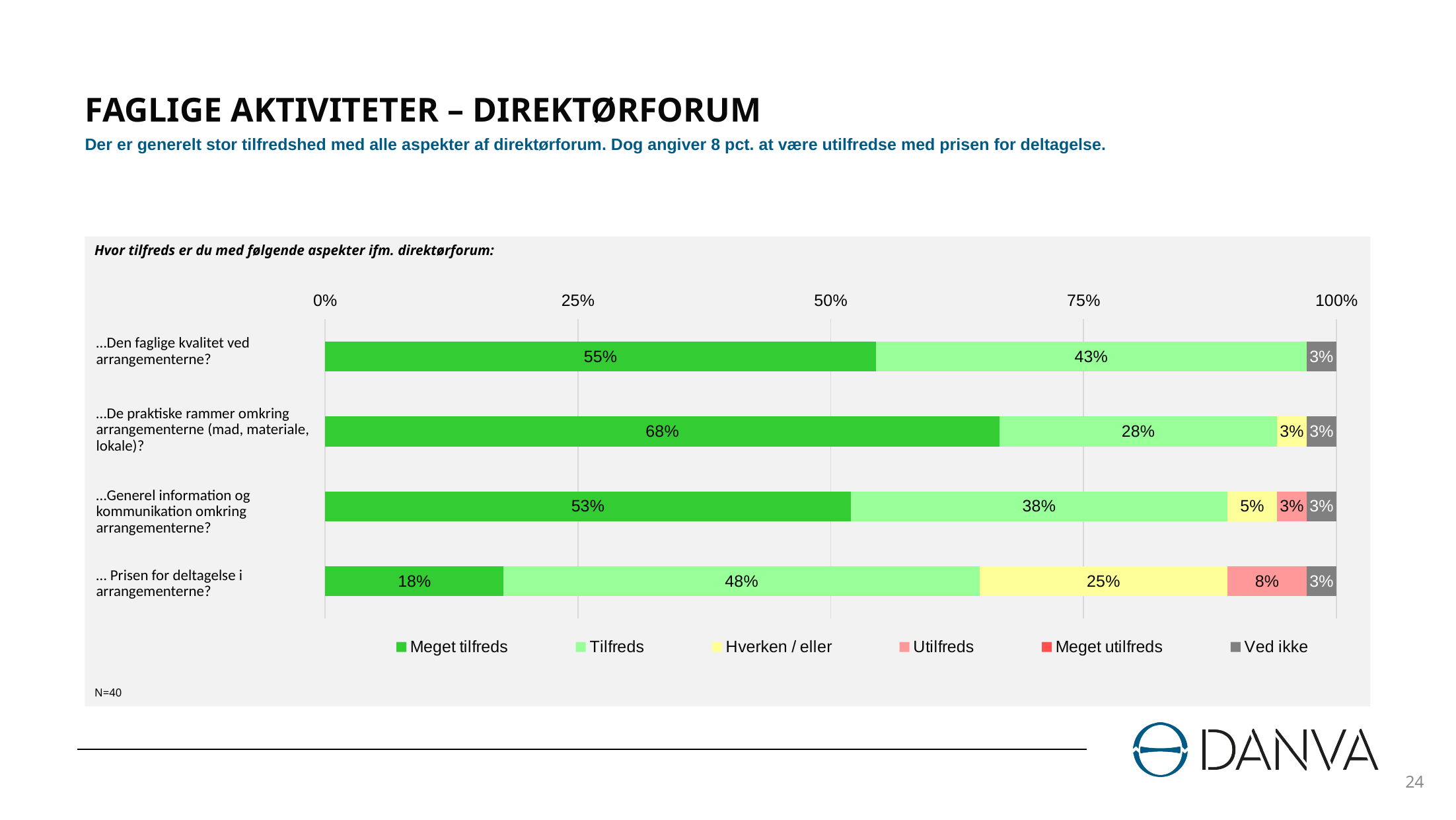
What percentage answered "Meget tilfreds" for "...Den faglige kvalitet ved arrangementerne?"? 55% What percentage answered "Tilfreds" for "... Prisen for deltagelse i arrangementerne?"? 48% Which aspect has the lowest "Meget tilfreds" share? ... Prisen for deltagelse i arrangementerne? What type of chart is shown on the slide? Stacked bar chart Which aspect has the highest "Meget tilfreds" share? ...De praktiske rammer omkring arrangementerne (mad, materiale, lokale)? What is the "Hverken / eller" share for "...Generel information og kommunikation omkring arrangementerne?"? 5% What sample size (N) is stated below the chart? N=40 How many aspects (categories) are shown in the chart? 4 Which has the larger "Tilfreds" share: "...Den faglige kvalitet ved arrangementerne?" or "...Generel information og kommunikation omkring arrangementerne?"? ...Den faglige kvalitet ved arrangementerne? What is the "Utilfreds" share for "... Prisen for deltagelse i arrangementerne?"? 8% How many percentage points higher is the "Meget tilfreds" share for "...De praktiske rammer omkring arrangementerne" than for "...Den faglige kvalitet ved arrangementerne?"? 13 percentage points How many series does the legend list? 6